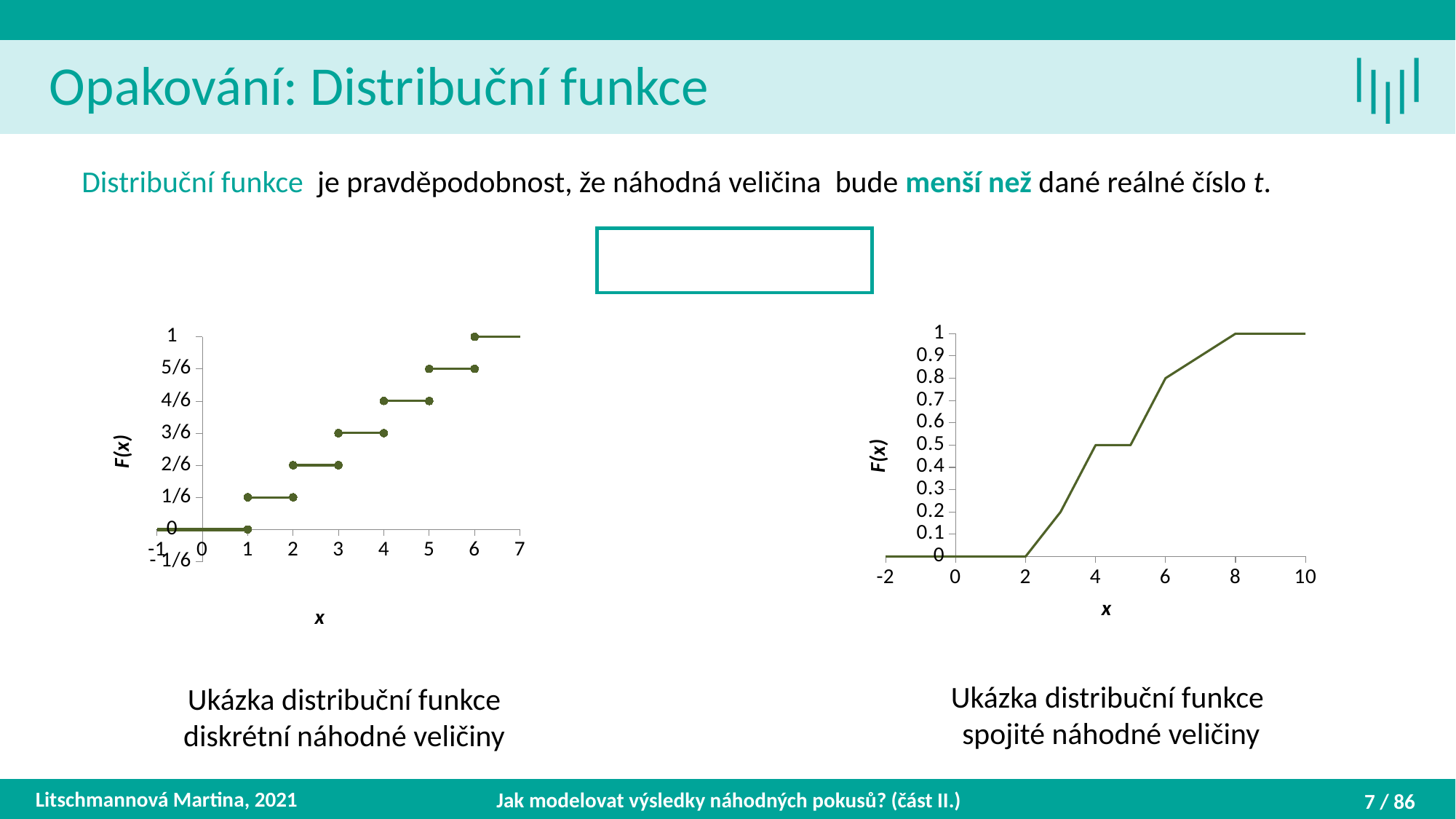
What kind of chart is the left chart (Ukázka distribuční funkce diskrétní náhodné veličiny)? line chart In the left chart, what is the highest value F(x) reaches? 1 In the right chart, what is the value of F(x) at x = 8? 1 In the right chart, what is the value of F(x) at x = 4? 0.5 In the right chart, what is the value of F(x) at x = 2? 0 In the left chart, what is the value of F(x) on the step between x = 3 and x = 4? 3/6 What kind of chart is the right chart (Ukázka distribuční funkce spojité náhodné veličiny)? line chart In the right chart, what is the value of F(x) at x = 6? 0.8 What is the label of the vertical axis in the left chart? F(x) In the right chart, do the values of F(x) rise or fall as x increases from 2 to 8? rise In the left chart, what is the value of F(x) on the step between x = 1 and x = 2? 1/6